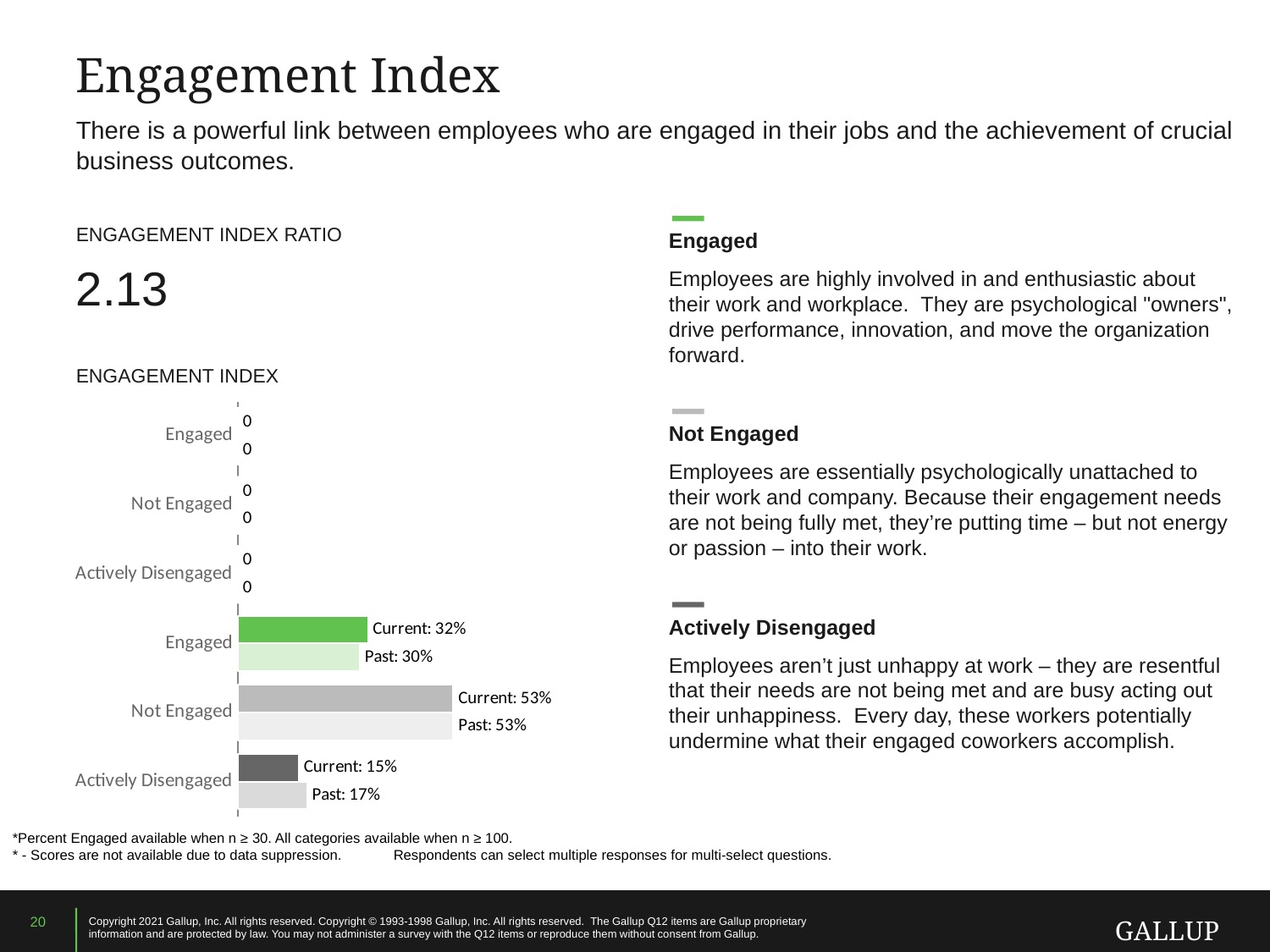
In the Engagement Index chart, what is the Past value for Actively Disengaged? 17% In the Engagement Index chart, is the Current or the Past value larger for Engaged? Current What kind of chart is the Engagement Index chart? Bar chart In the Engagement Index chart, which category has the lowest Current value? Actively Disengaged In the Engagement Index chart, what is the Current value for Engaged? 32% In the Engagement Index chart, what is the Current value for Not Engaged? 53% In the Engagement Index chart, which category has the highest Current value? Not Engaged In the Engagement Index chart, what is the Current value for Actively Disengaged? 15% In the Engagement Index chart, by how many percentage points did Actively Disengaged fall from Past to Current? 2 percentage points In the Engagement Index chart, what is the Past value for Engaged? 30% What is the title of the chart on the slide? ENGAGEMENT INDEX In the Engagement Index chart, by how many percentage points does the Current Engaged value exceed the Past Engaged value? 2 percentage points